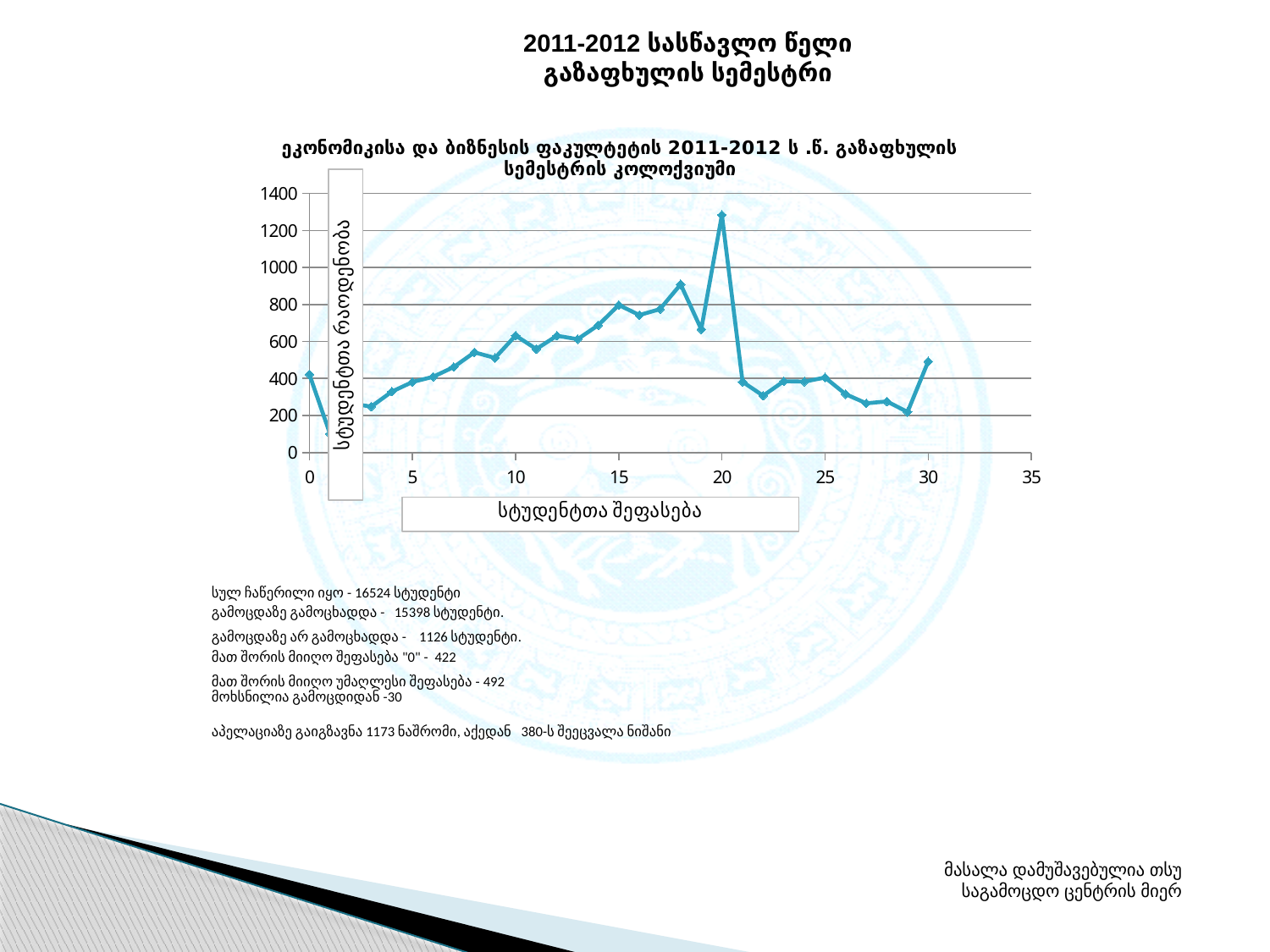
What kind of chart is shown on the slide? line chart At which x-axis value (student grade) does the line reach its highest point? 20 Is the value at x = 1 greater or less than 200? less Which is larger, the value at x = 20 or the value at x = 18? x = 20 What is the label on the vertical (y) axis of the chart? სტუდენტთა რაოდენობა Is the value at x = 18 greater or less than 800? greater Which is larger, the value at x = 15 or the value at x = 5? x = 15 Is the value at x = 20 greater or less than 1200? greater Do the values generally rise or fall along the x axis between x = 21 and x = 29? fall At which x-axis value (student grade) does the line reach its lowest point? 1